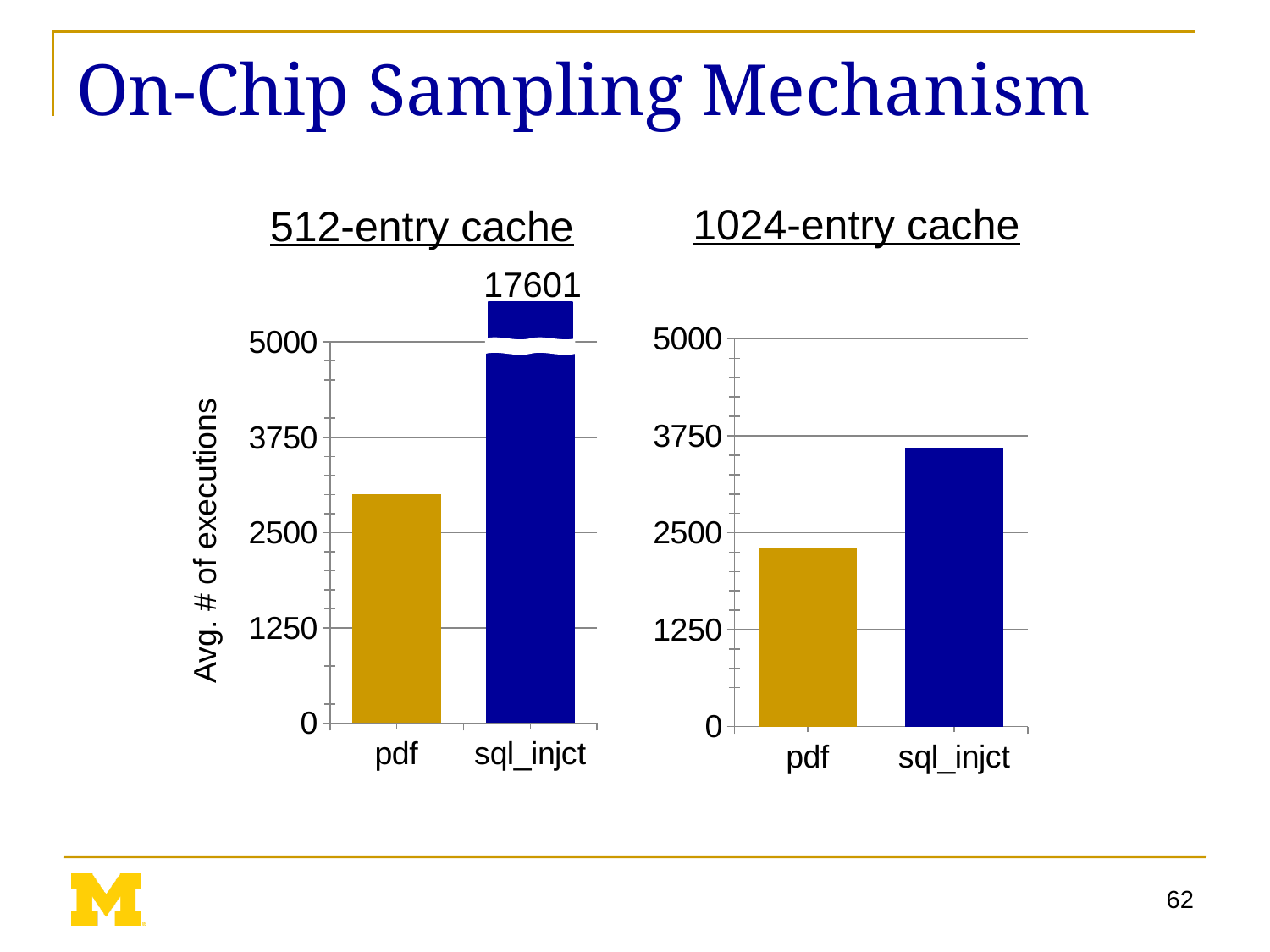
In the 512-entry cache chart, which category has the lowest value? pdf How many categories are shown in the 512-entry cache chart? 2 In the 1024-entry cache chart, is the value for sql_injct greater or less than 3750? less In the 512-entry cache chart, which category has the highest value? sql_injct In the 1024-entry cache chart, is the value for pdf greater or less than 2500? less What kind of chart is the 1024-entry cache chart? bar chart In the 1024-entry cache chart, which category has the highest value? sql_injct In the 512-entry cache chart, is the value for pdf greater or less than 2500? greater What is the label on the y axis of the 512-entry cache chart? Avg. # of executions In the 1024-entry cache chart, which category has the lowest value? pdf In the 512-entry cache chart, what is the value printed for sql_injct? 17601 In the 1024-entry cache chart, which is larger, the value for pdf or the value for sql_injct? sql_injct